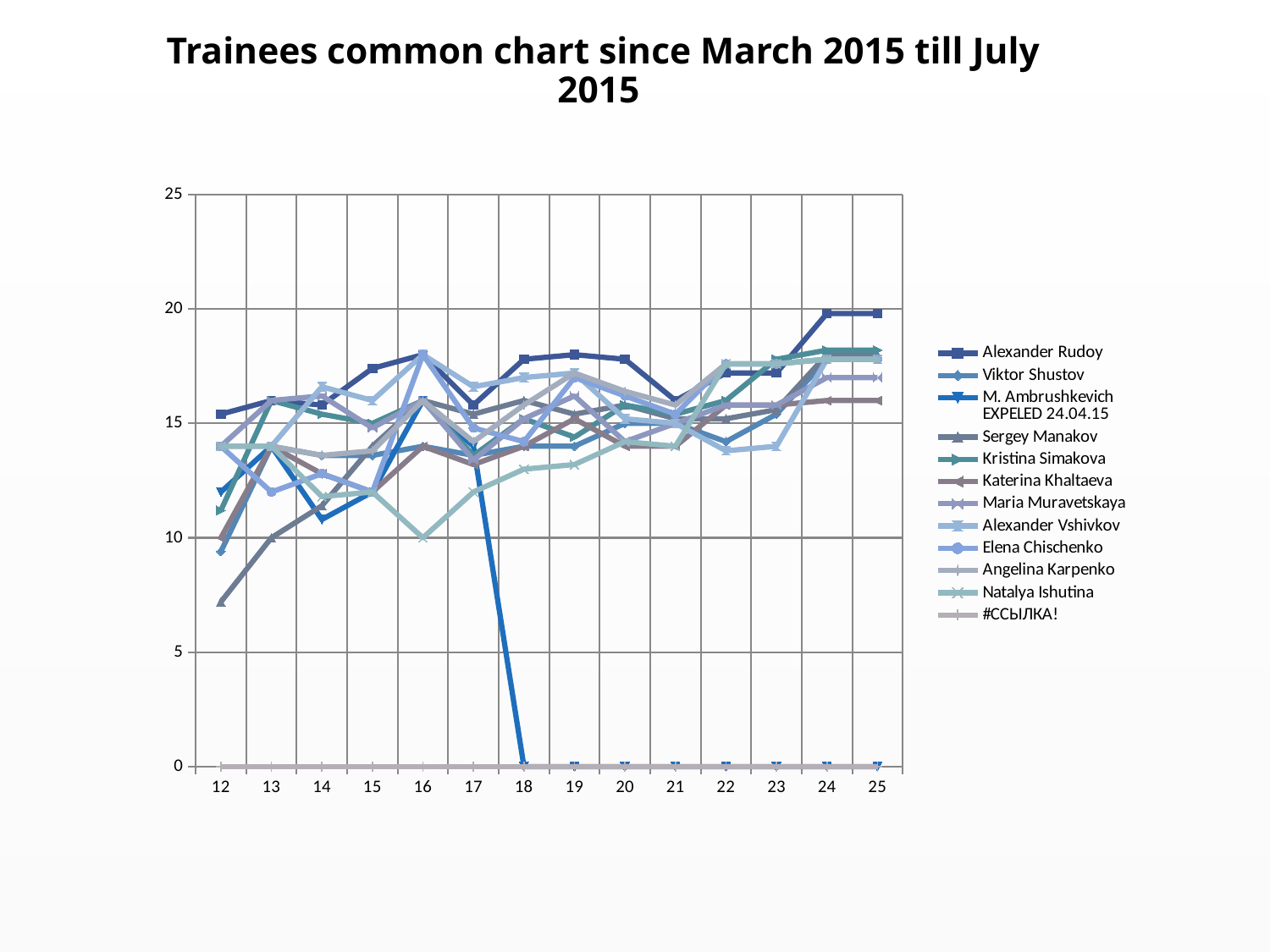
Which series drops to 0 at x = 18 and stays there? M. Ambrushkevich EXPELED 24.04.15 At x = 12, which is larger: Alexander Rudoy or Sergey Manakov? Alexander Rudoy Is the value for Alexander Rudoy at x = 24 greater or less than 15? greater Does the Alexander Rudoy line rise or fall overall from x = 12 to x = 25? rise What kind of chart is shown on the slide? line chart Which series is highest at x = 25? Alexander Rudoy What is the title of the chart? Trainees common chart since March 2015 till July 2015 Is the value for Sergey Manakov at x = 12 greater or less than 10? less Is the value for M. Ambrushkevich EXPELED 24.04.15 at x = 18 greater or less than 5? less Which series is highest at x = 24? Alexander Rudoy How many points are there along the x axis? 14 How many series does the legend list? 12